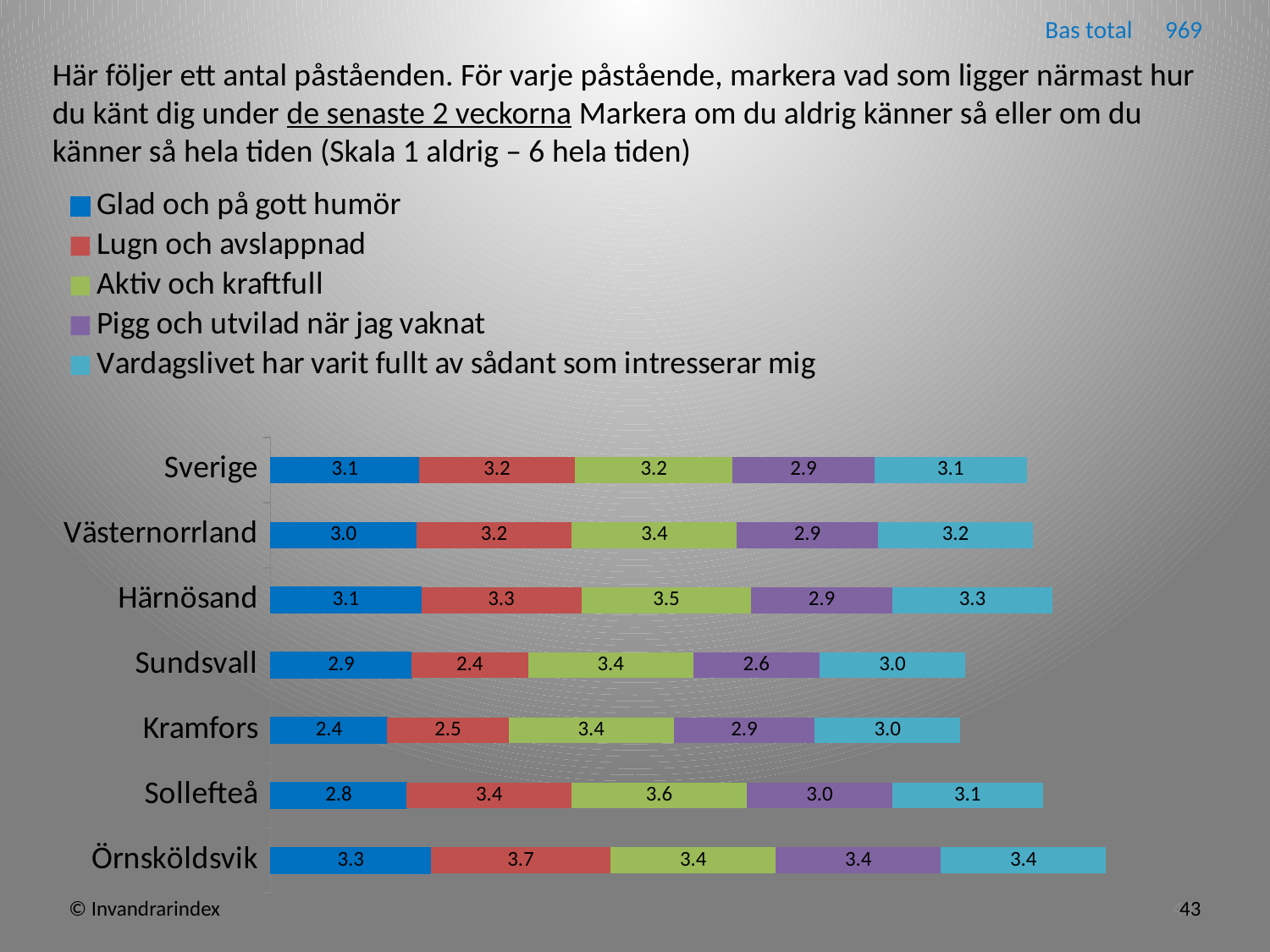
Which region has the lowest value for "Glad och på gott humör"? Kramfors What is the value for "Aktiv och kraftfull" for Sollefteå? 3.6 How many categories (regions) are shown on the chart? 7 What kind of chart is shown on the slide? Stacked bar chart What is the difference between the "Lugn och avslappnad" values for Örnsköldsvik and Sundsvall? 1.3 What is the total of the stacked bar for Örnsköldsvik? 17.2 What is the value for "Lugn och avslappnad" for Sundsvall? 2.4 How many series does the legend list? 5 Which is larger: the "Aktiv och kraftfull" value for Härnösand or for Sverige? Härnösand What is the value for "Pigg och utvilad när jag vaknat" for Kramfors? 2.9 What is the value for "Glad och på gott humör" for Örnsköldsvik? 3.3 Which region has the highest value for "Lugn och avslappnad"? Örnsköldsvik